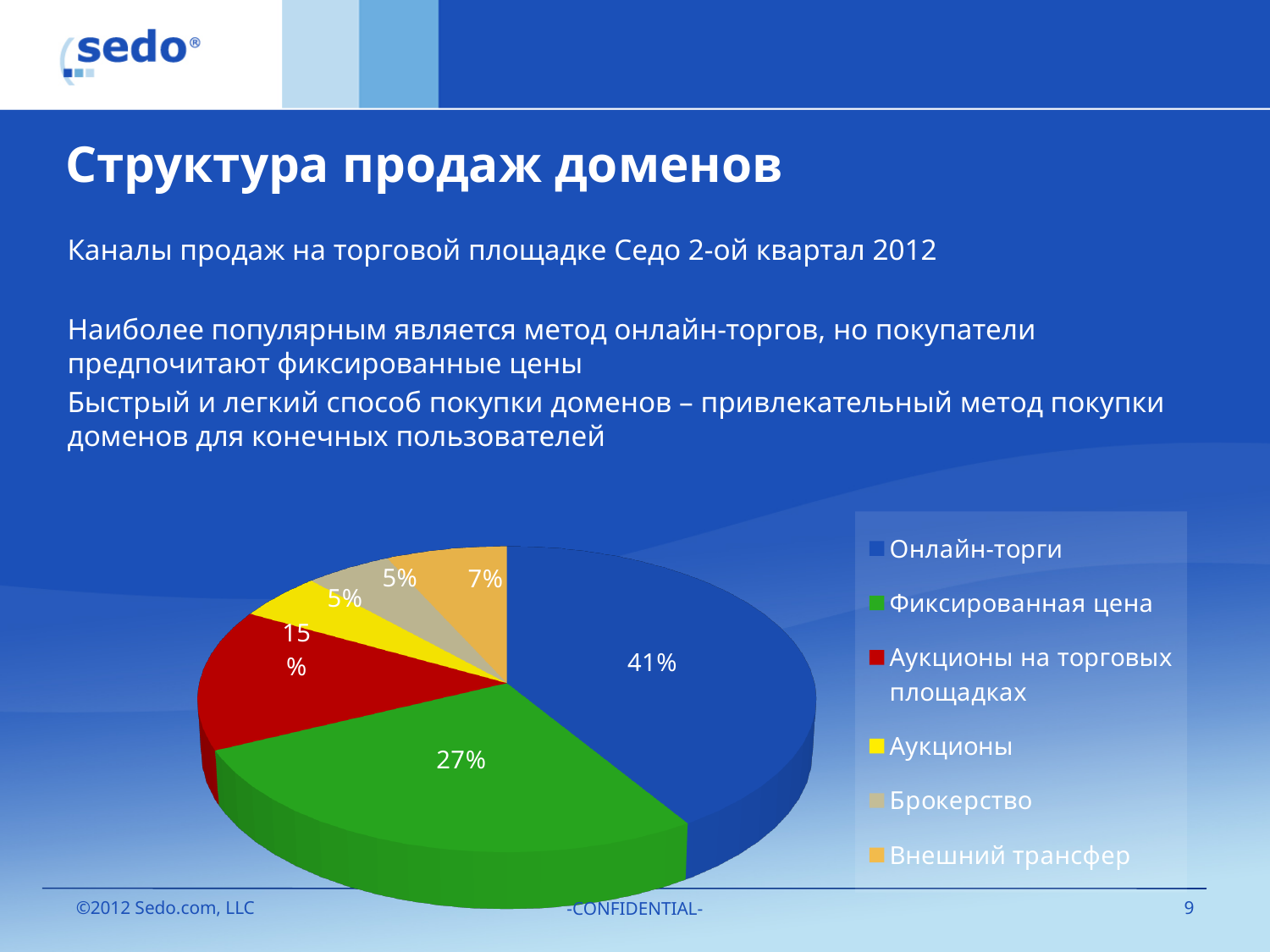
What share of the pie does Онлайн-торги have? 41% How many categories does the legend list? 6 Which category has the largest slice of the pie? Онлайн-торги What share of the pie does Аукционы на торговых площадках have? 15% What share of the pie does Фиксированная цена have? 27% What type of chart is shown on the slide? pie chart What share of the pie does Брокерство have? 5% What is the difference in percentage points between Онлайн-торги and Фиксированная цена? 14 What share of the pie does Внешний трансфер have? 7% What is the combined share of Онлайн-торги and Фиксированная цена? 68% Which is larger, the slice for Внешний трансфер or the slice for Аукционы? Внешний трансфер What colour is the slice for Фиксированная цена? green